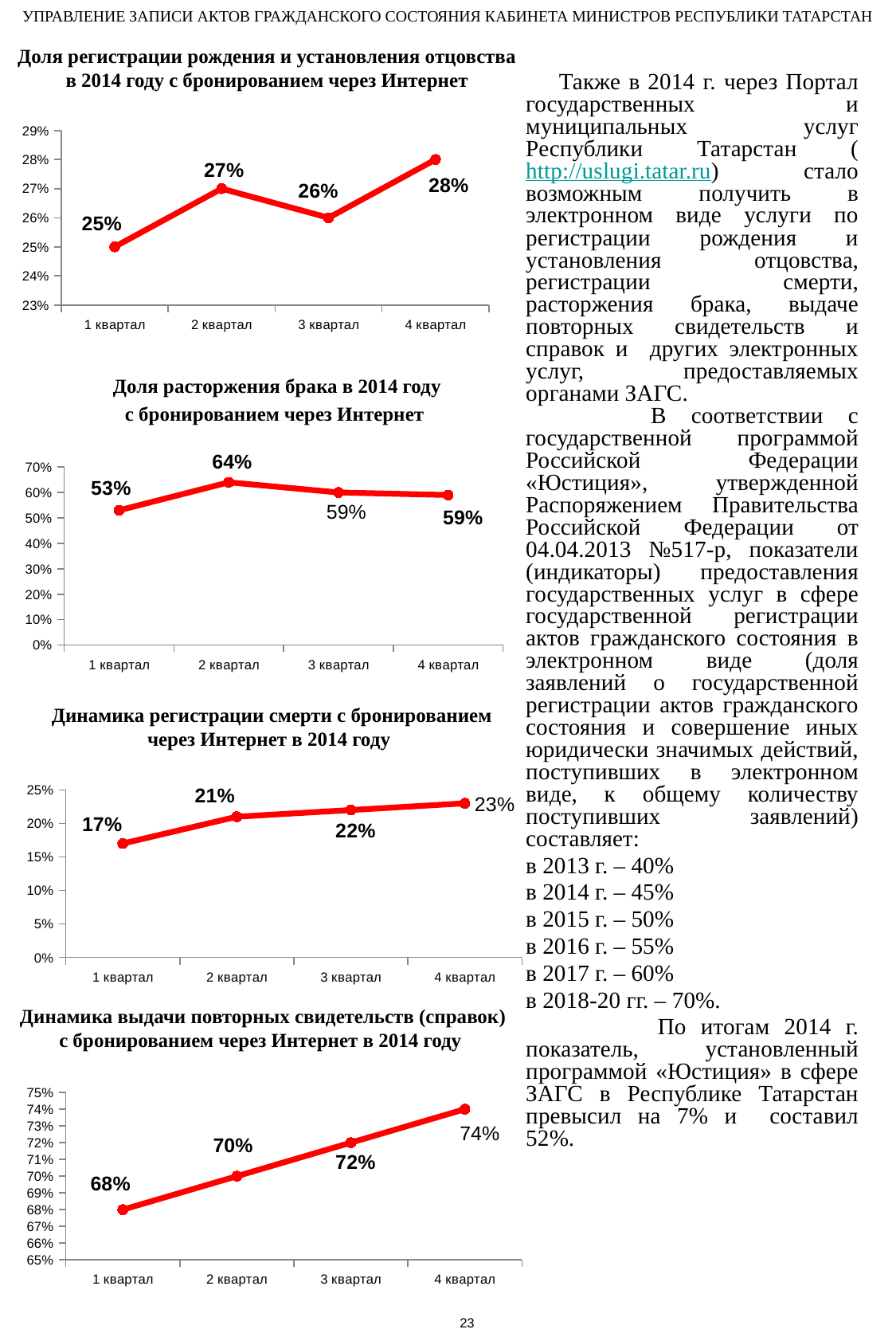
In the chart 'Динамика регистрации смерти с бронированием через Интернет в 2014 году', do the values rise or fall from 1 квартал to 4 квартал? rise In the chart 'Динамика выдачи повторных свидетельств (справок) с бронированием через Интернет в 2014 году', what is the value for 3 квартал? 72% In the chart 'Доля расторжения брака в 2014 году с бронированием через Интернет', what is the difference between the values for 2 квартал and 1 квартал? 11% In the chart 'Доля расторжения брака в 2014 году с бронированием через Интернет', what is the value for 1 квартал? 53% In the chart 'Доля регистрации рождения и установления отцовства в 2014 году с бронированием через Интернет', which quarter has the highest value? 4 квартал In the chart 'Доля регистрации рождения и установления отцовства в 2014 году с бронированием через Интернет', what is the value for 2 квартал? 27% What type of chart is 'Доля расторжения брака в 2014 году с бронированием через Интернет'? line chart In the chart 'Динамика выдачи повторных свидетельств (справок) с бронированием через Интернет в 2014 году', what is the difference between the values for 4 квартал and 1 квартал? 6% In the chart 'Динамика выдачи повторных свидетельств (справок) с бронированием через Интернет в 2014 году', which is larger: the value for 2 квартал or 4 квартал? 4 квартал How many quarters are plotted in the chart 'Динамика регистрации смерти с бронированием через Интернет в 2014 году'? 4 In the chart 'Динамика регистрации смерти с бронированием через Интернет в 2014 году', what is the value for 4 квартал? 23% In the chart 'Доля расторжения брака в 2014 году с бронированием через Интернет', which quarter has the lowest value? 1 квартал